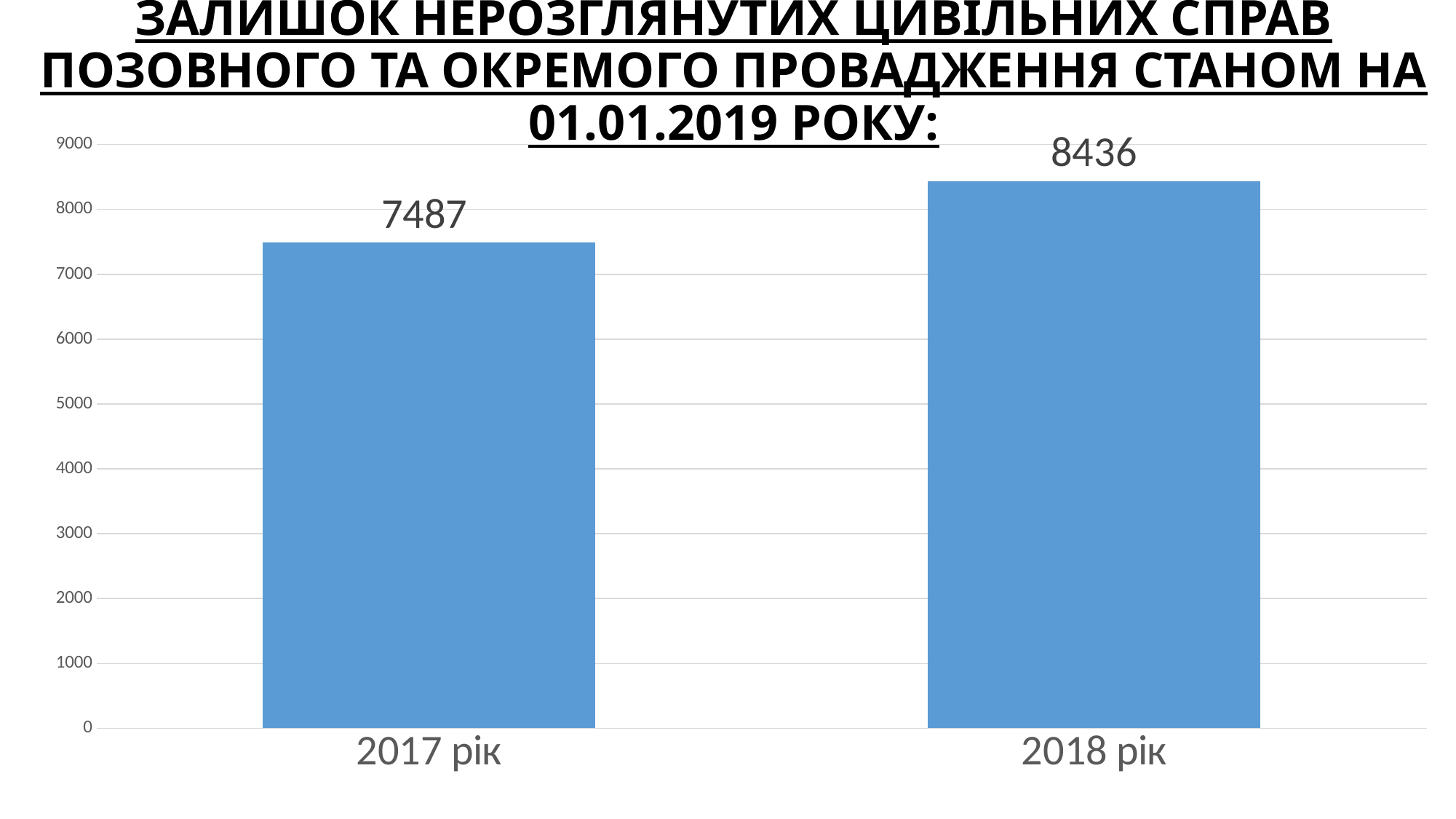
What is the value for 2018 рік? 8436 Which category has the highest value? 2018 рік Which category has the lowest value? 2017 рік Do the values rise or fall from 2017 рік to 2018 рік? rise Is the value for 2018 рік greater or less than 8000? greater Is the value for 2017 рік greater or less than 8000? less What kind of chart is shown on the slide? bar chart What is the highest value shown on the vertical axis? 9000 Which is larger, the value for 2017 рік or the value for 2018 рік? 2018 рік How many categories are shown on the chart? 2 What is the difference between the values for 2018 рік and 2017 рік? 949 What is the value for 2017 рік? 7487